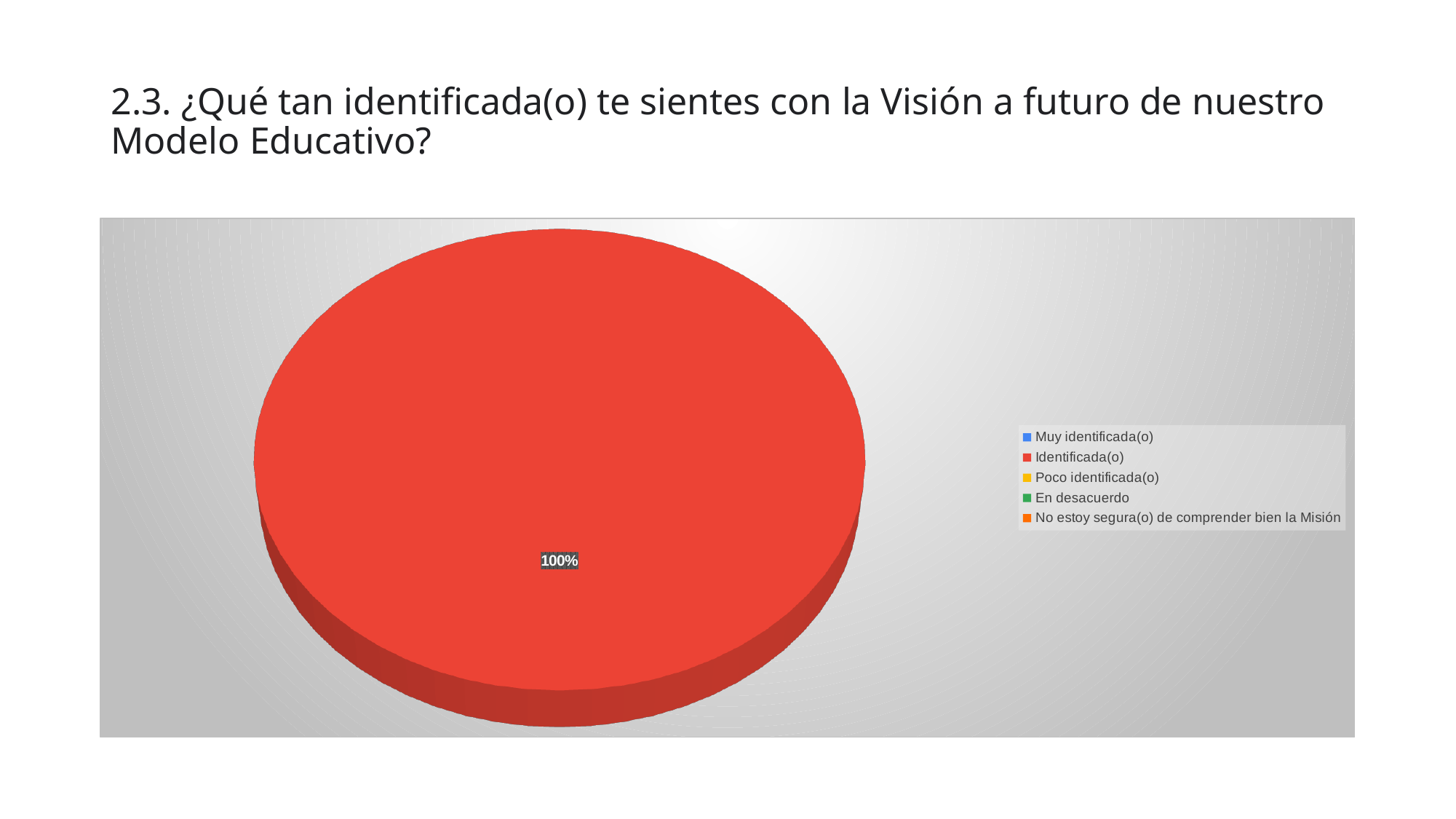
Which category has the largest share of the pie? Identificada(o) What is the only percentage label printed on the pie? 100% What kind of chart is shown on the slide? pie chart Is the share for Identificada(o) greater or less than 50%? greater Which is larger, the share for Identificada(o) or the share for Muy identificada(o)? Identificada(o) What colour is the Identificada(o) slice? red What share of the pie does the Identificada(o) slice represent? 100% How many categories does the legend list? 5 Which legend entry is listed last? No estoy segura(o) de comprender bien la Misión